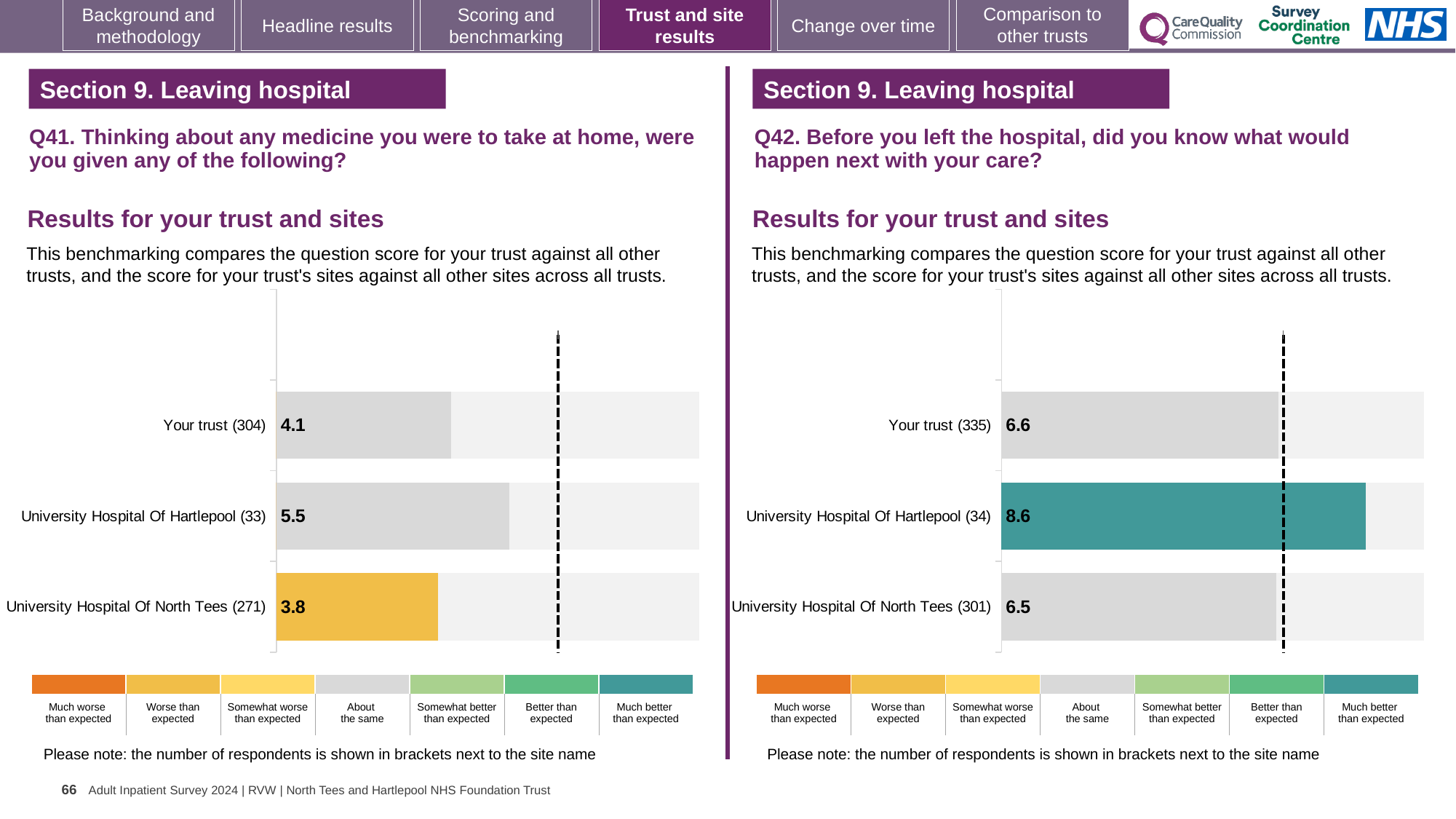
On the Q41 chart (left), what is the score for University Hospital Of North Tees? 3.8 On the Q42 chart (right), which is larger: the score for Your trust or for University Hospital Of North Tees? Your trust On the Q41 chart (left), how many respondents are shown in brackets for University Hospital Of North Tees? 271 On the Q42 chart (right), which site or trust has the lowest score? University Hospital Of North Tees On the Q41 chart (left), how many bars are plotted? 3 What kind of chart is used on the Q41 chart (left)? Bar chart On the Q41 chart (left), which site or trust has the highest score? University Hospital Of Hartlepool On the Q41 chart (left), what is the difference between the scores for University Hospital Of Hartlepool and University Hospital Of North Tees? 1.7 On the Q41 chart (left), what is the score for Your trust? 4.1 On the Q42 chart (right), what is the score for Your trust? 6.6 On the Q42 chart (right), what is the difference between the scores for University Hospital Of Hartlepool and Your trust? 2.0 On the Q42 chart (right), what is the score for University Hospital Of Hartlepool? 8.6